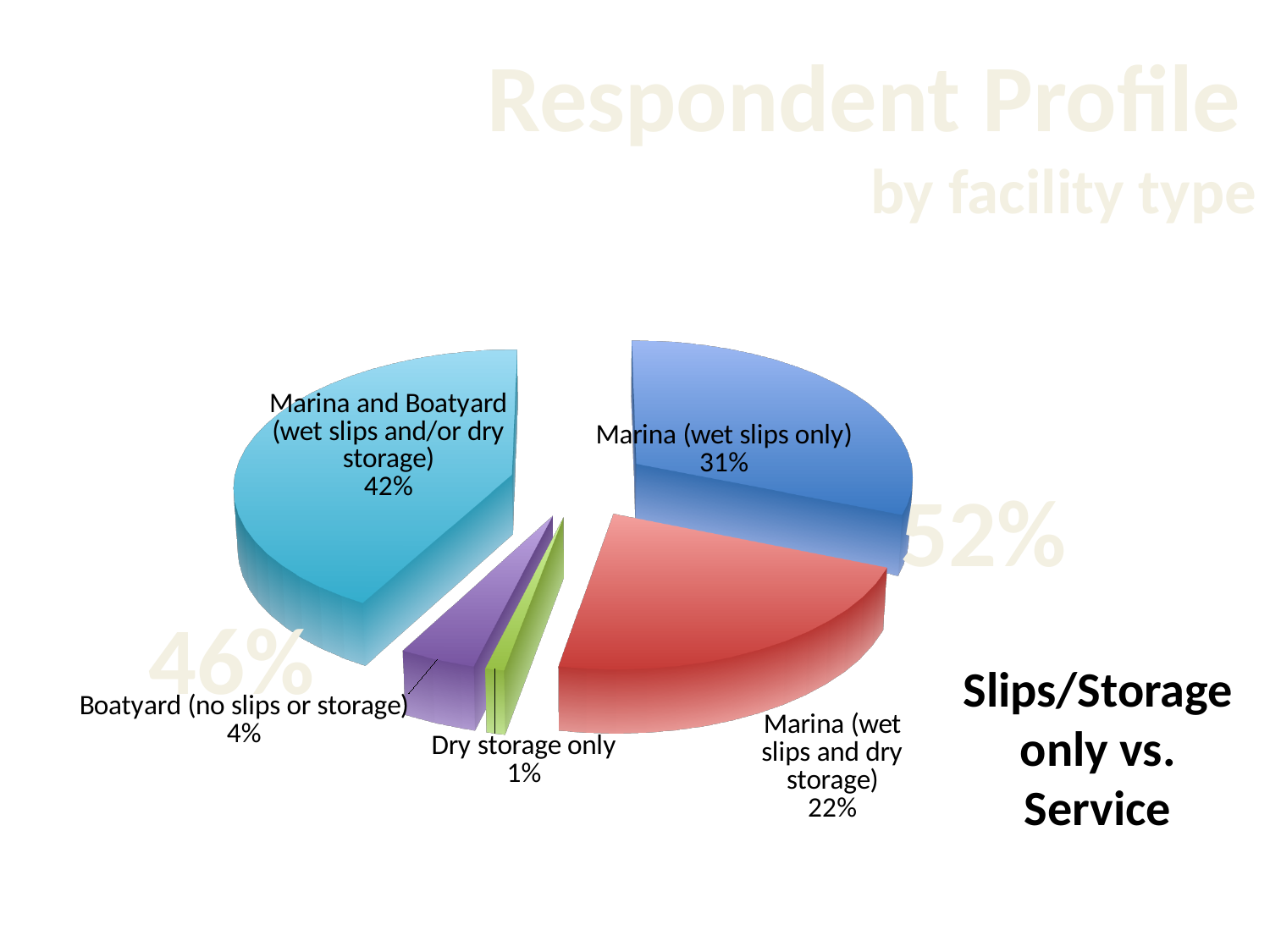
Which has a larger share: Boatyard (no slips or storage) or Dry storage only? Boatyard (no slips or storage) What share of respondents are Boatyard (no slips or storage)? 4% What is the difference in share between Marina (wet slips only) and Marina (wet slips and dry storage)? 9% Which facility type has the smallest share of respondents? Dry storage only What is the title of the slide containing the pie chart? Respondent Profile by facility type What share of respondents are Marina (wet slips only)? 31% What share of respondents are Dry storage only? 1% What kind of chart is shown on the slide? Pie chart What share of respondents are Marina and Boatyard (wet slips and/or dry storage)? 42% Which facility type has the largest share of respondents? Marina and Boatyard (wet slips and/or dry storage) How many facility types are shown in the pie chart? 5 What share of respondents are Marina (wet slips and dry storage)? 22%